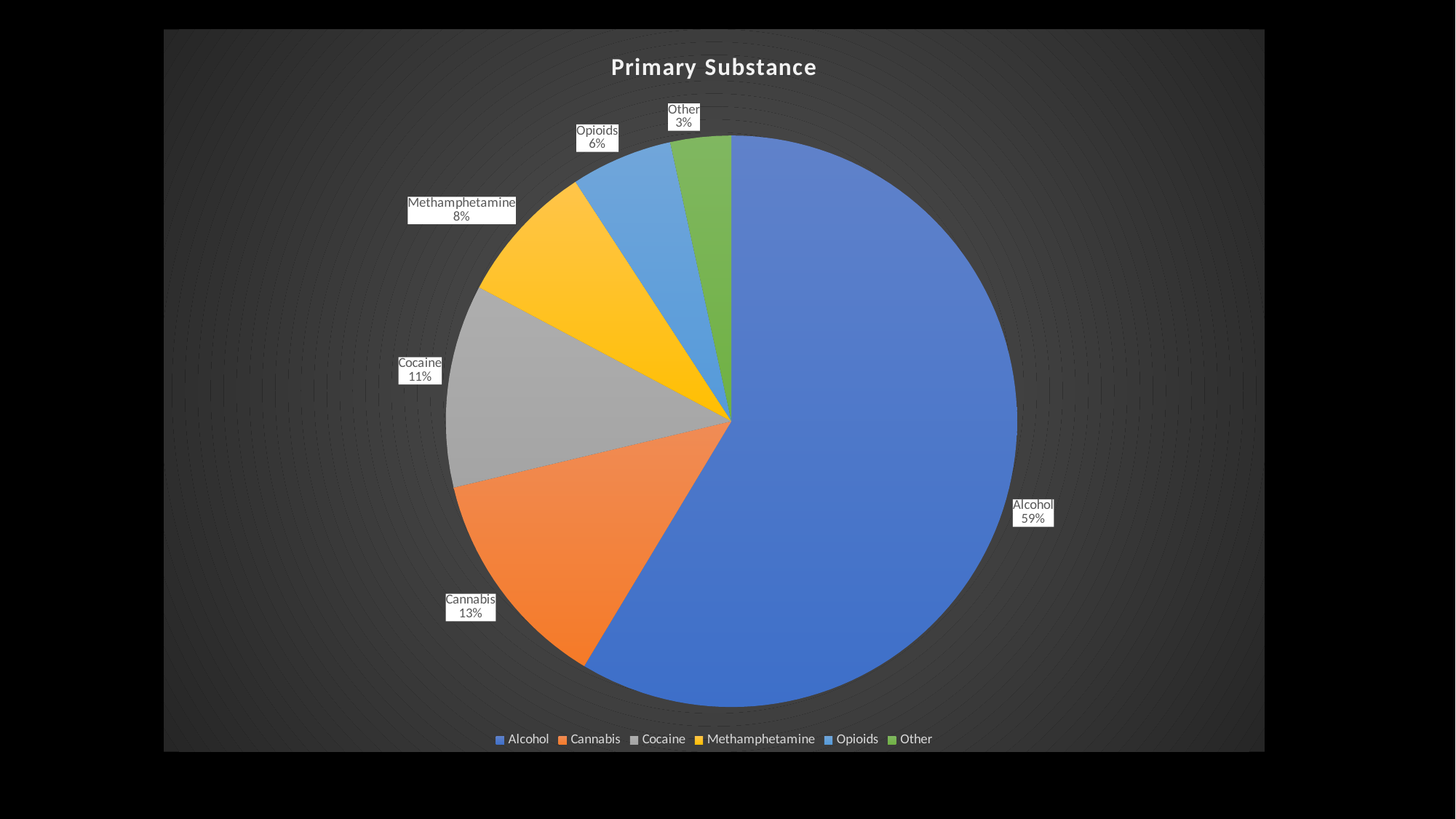
Which category has the largest slice of the pie? Alcohol What is the value shown for Methamphetamine? 8% How many categories are shown in the pie chart? 6 What is the value shown for Opioids? 6% Which category has the smallest slice of the pie? Other What is the difference in percentage points between Cannabis and Cocaine? 2 What is the title of the chart? Primary Substance What kind of chart is shown on the slide? pie chart Which is larger, the share for Cocaine or the share for Methamphetamine? Cocaine What colour is the Methamphetamine slice? yellow What share of the pie does Alcohol represent? 59% What is the value shown for Cannabis? 13%